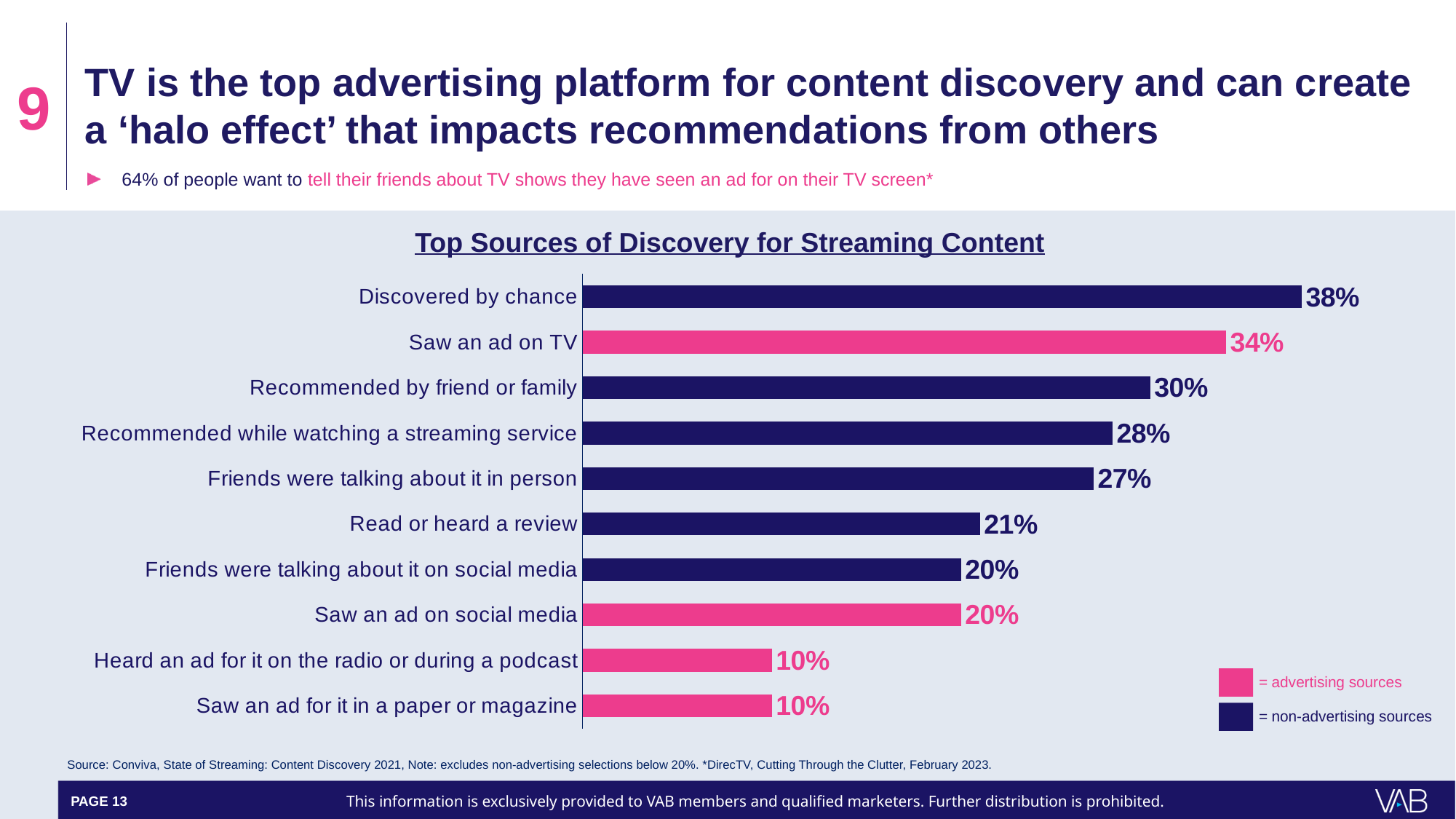
What is the difference between 'Recommended by friend or family' and 'Saw an ad on social media'? 10% How many categories are shown in the chart? 10 Which source of discovery has the highest value? Discovered by chance What is the value for 'Read or heard a review'? 21% What is the title of the chart? Top Sources of Discovery for Streaming Content How many categories have a value of 10%? 2 According to the legend, what do the pink bars represent? Advertising sources Which is larger, 'Friends were talking about it in person' or 'Read or heard a review'? Friends were talking about it in person What kind of chart is shown on the slide? Bar chart What is the value for 'Recommended while watching a streaming service'? 28% What is the difference between 'Discovered by chance' and 'Saw an ad on TV'? 4% What is the value for 'Saw an ad on TV'? 34%